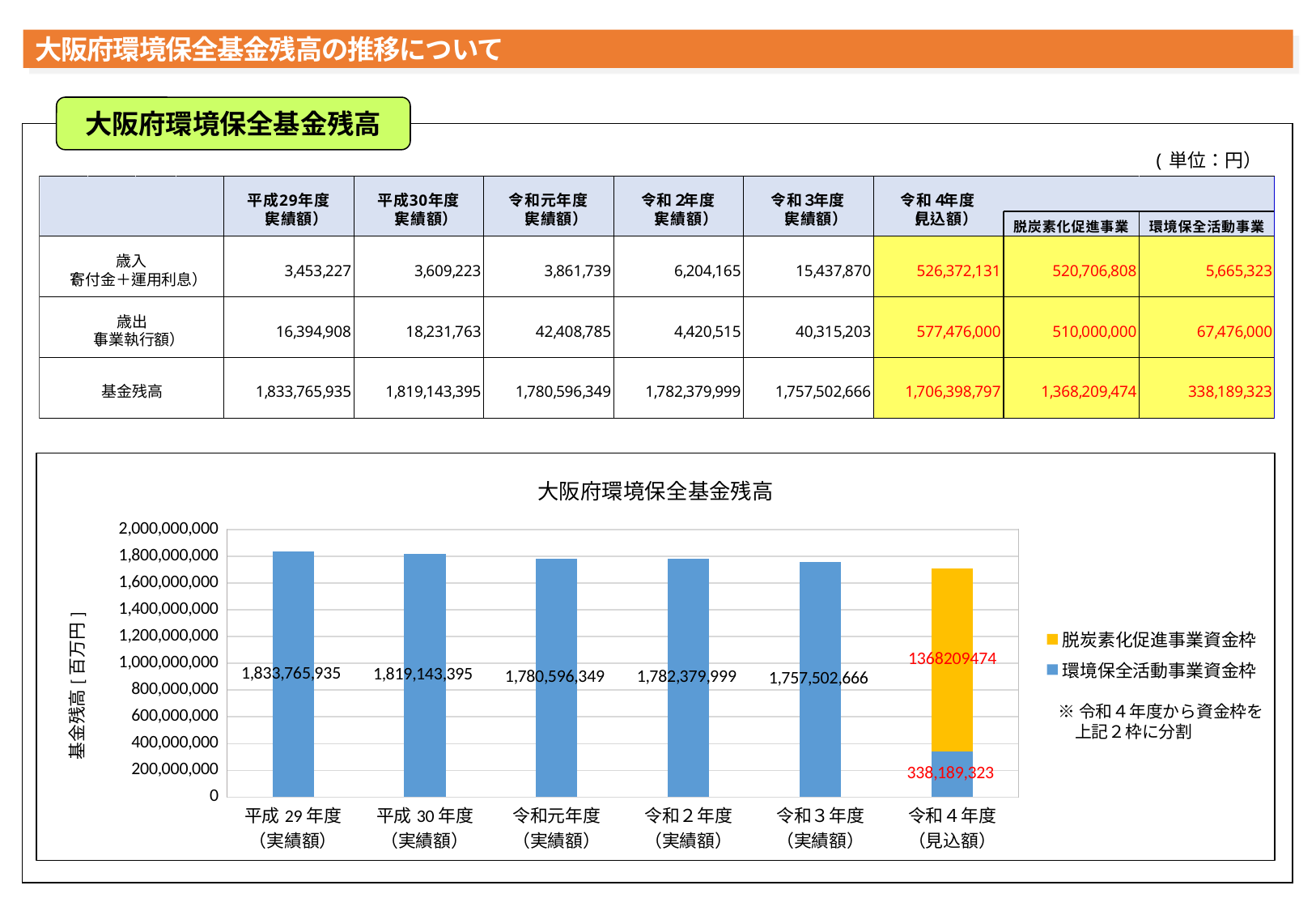
In the chart, what is the value of the 環境保全活動事業資金枠 segment for 令和４年度（見込額）? 338,189,323 How many series does the chart legend list? 2 Which year has the lowest total bar in the chart? 令和４年度（見込額） What is the value of the bar for 平成29年度（実績額） in the chart 大阪府環境保全基金残高? 1,833,765,935 Which is larger in the chart, the value for 令和元年度（実績額） or 令和２年度（実績額）? 令和２年度（実績額） How many years are shown on the x axis of the chart? 6 What is the difference between the values for 平成29年度（実績額） and 平成30年度（実績額） in the chart? 14,622,540 Which year has the highest bar in the chart? 平成29年度（実績額） What is the value of the bar for 令和３年度（実績額） in the chart? 1,757,502,666 In the chart, what is the value of the 脱炭素化促進事業資金枠 segment for 令和４年度（見込額）? 1368209474 What is the total of the stacked bar for 令和４年度（見込額） in the chart? 1,706,398,797 What kind of chart is shown on the slide? Bar chart